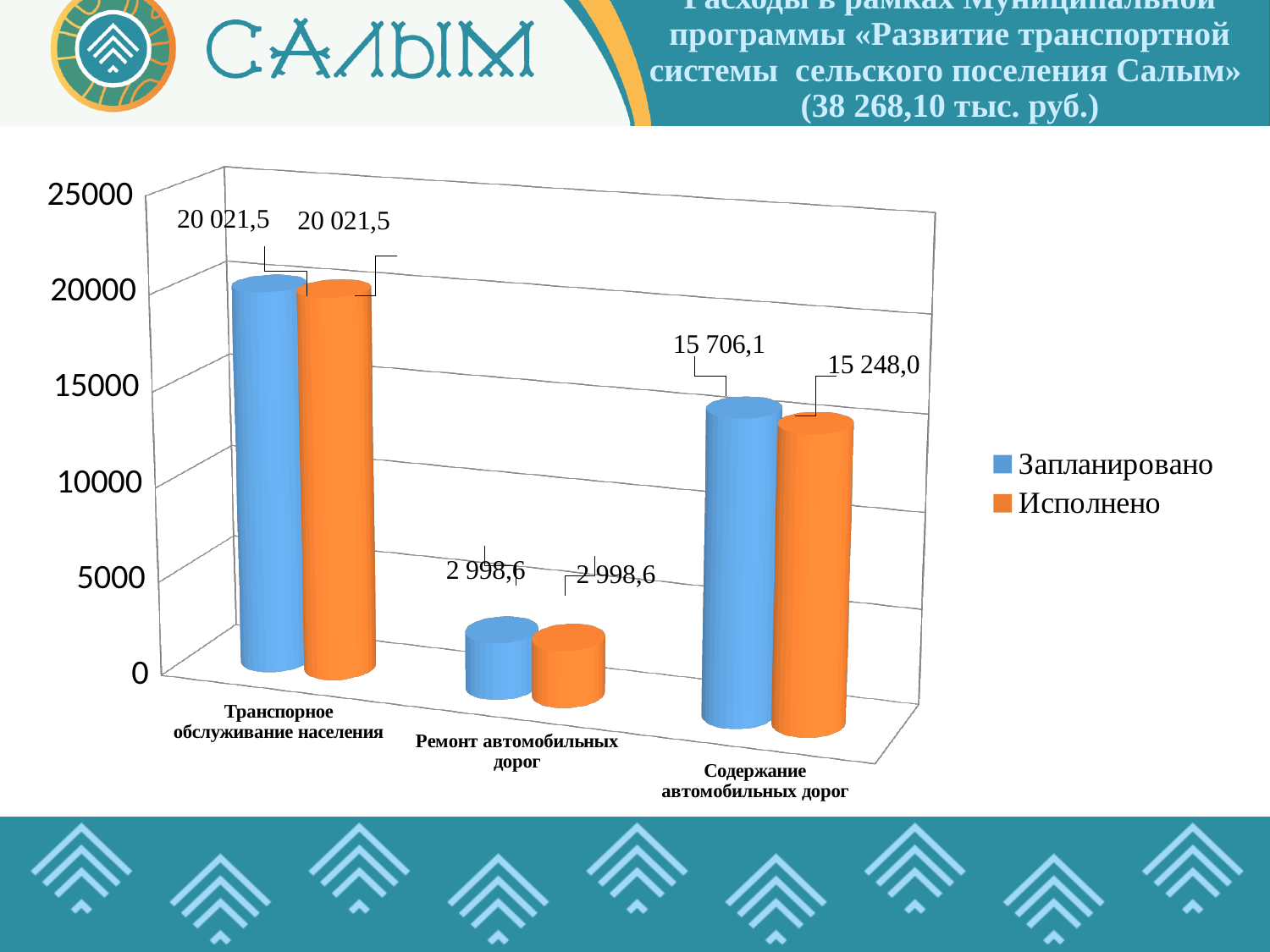
How many series does the chart legend list? 2 What is the difference between the planned and executed values for Содержание автомобильных дорог? 458,1 What is the planned (Запланировано) value for Транспортное обслуживание населения? 20 021,5 Is the executed (Исполнено) value for Ремонт автомобильных дорог greater or less than 5000? less Which is larger for Содержание автомобильных дорог: the planned (Запланировано) value or the executed (Исполнено) value? Запланировано What is the executed (Исполнено) value for Содержание автомобильных дорог? 15 248,0 Which category has the highest planned (Запланировано) value? Транспортное обслуживание населения What kind of chart is shown on the slide? bar chart What is the planned (Запланировано) value for Ремонт автомобильных дорог? 2 998,6 Which category has the lowest executed (Исполнено) value? Ремонт автомобильных дорог How many categories are shown on the x axis of the chart? 3 What is the planned (Запланировано) value for Содержание автомобильных дорог? 15 706,1